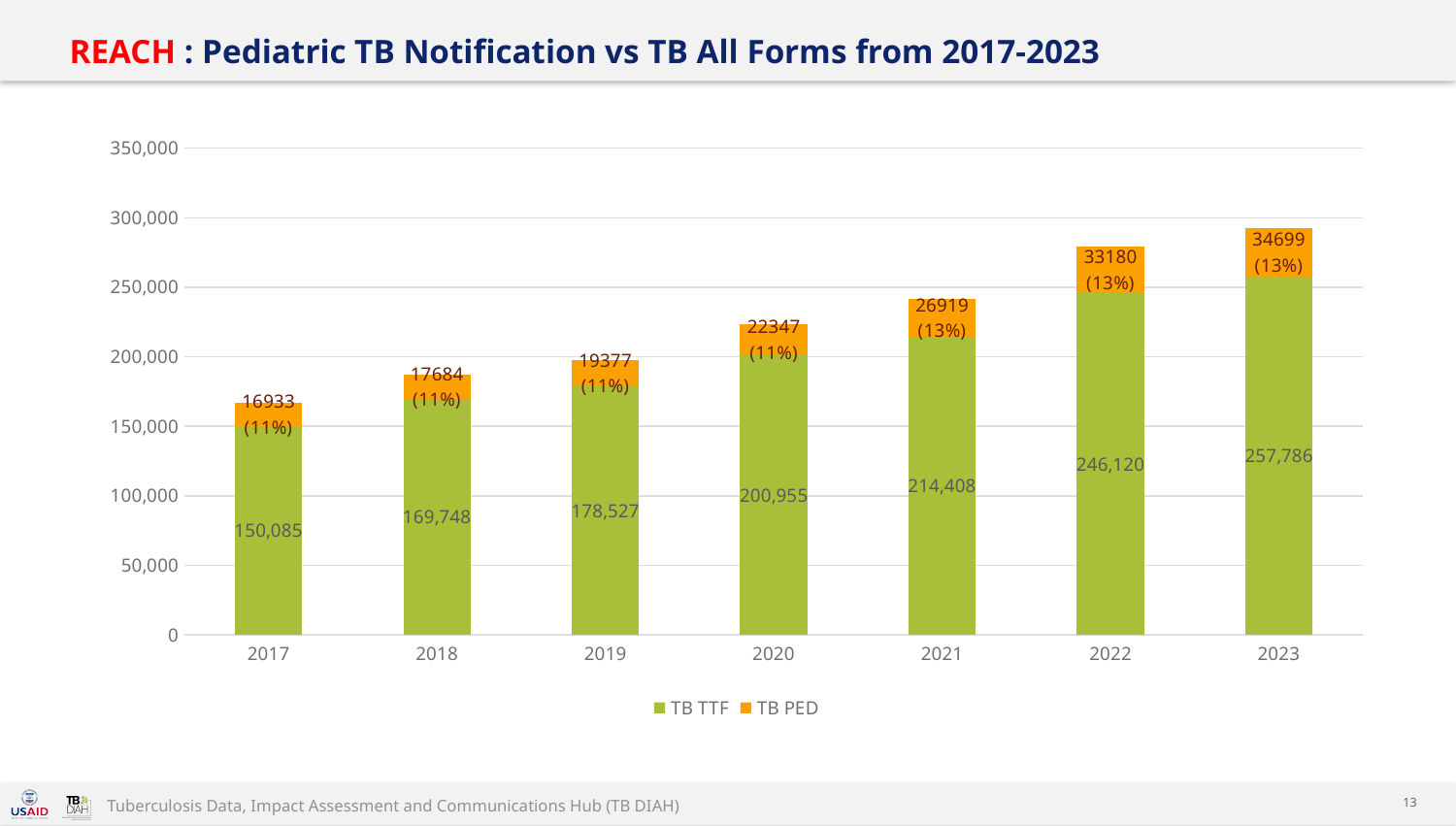
What is the total of the stacked bar for 2023? 292,485 What is the difference between the TB TTF values for 2023 and 2017? 107,701 Which is larger, the TB TTF value for 2021 or for 2019? 2021 What is the TB PED value for 2022? 33180 What is the TB TTF value for 2020? 200,955 What is the difference between the TB PED values for 2022 and 2021? 6261 How many series does the legend list? 2 Which year has the highest TB TTF value? 2023 Do the TB TTF values rise or fall from 2017 to 2023? rise What percentage is shown for TB PED in 2019? 11% How many years are shown on the x axis? 7 Which year has the lowest TB PED value? 2017